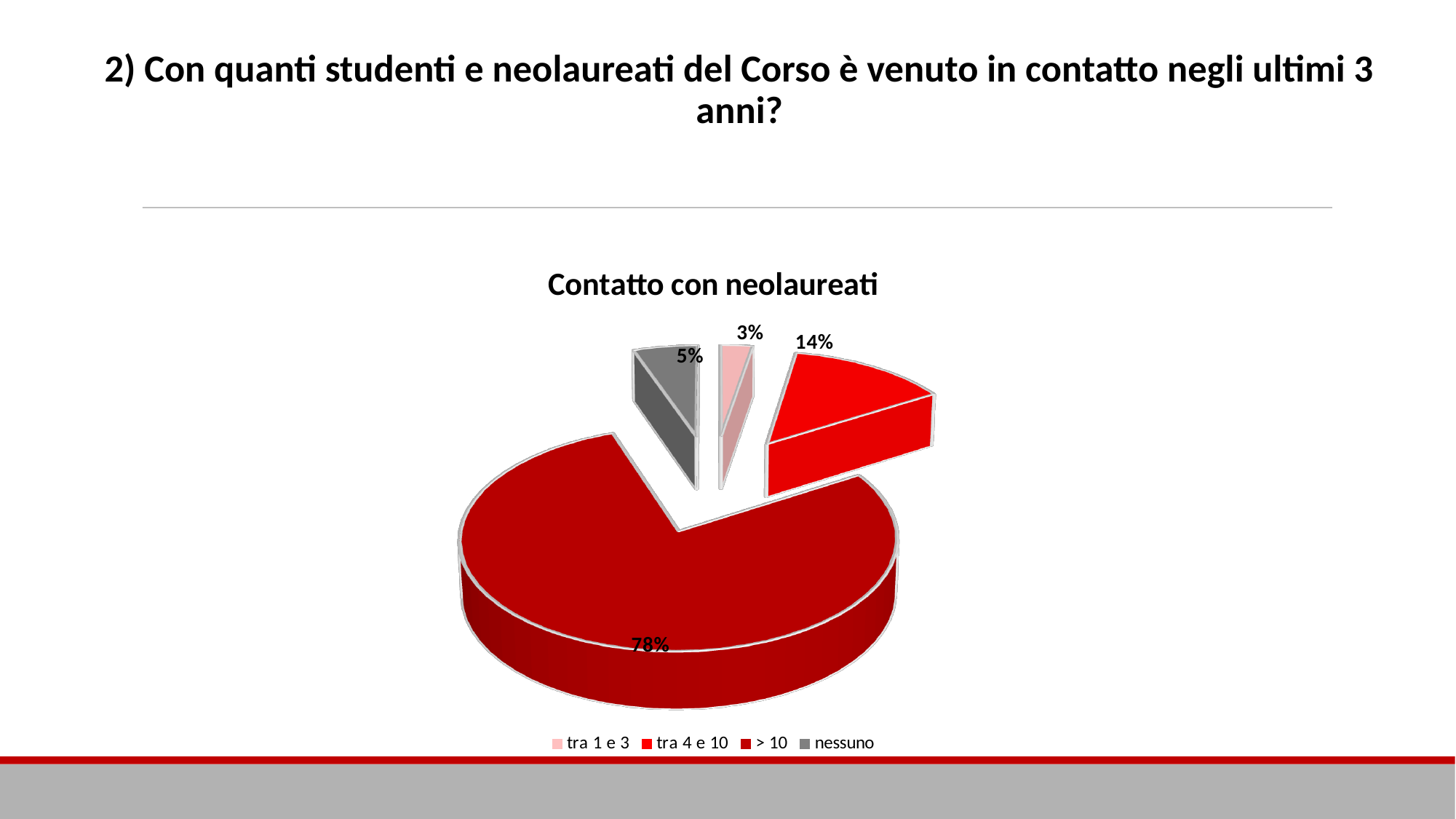
What share of the pie does the "> 10" slice represent? 78% What kind of chart is shown on the slide? Pie chart Which category has the largest slice of the pie? > 10 How many categories does the legend list? 4 What is the value shown for "tra 1 e 3"? 3% What is the difference in percentage points between "> 10" and "tra 4 e 10"? 64 Which category has the smallest slice of the pie? tra 1 e 3 Which is larger, the slice for "nessuno" or the slice for "tra 1 e 3"? nessuno What colour is the slice for "nessuno"? Grey What is the title of the chart? Contatto con neolaureati What is the value shown for "nessuno"? 5% What is the value shown for "tra 4 e 10"? 14%